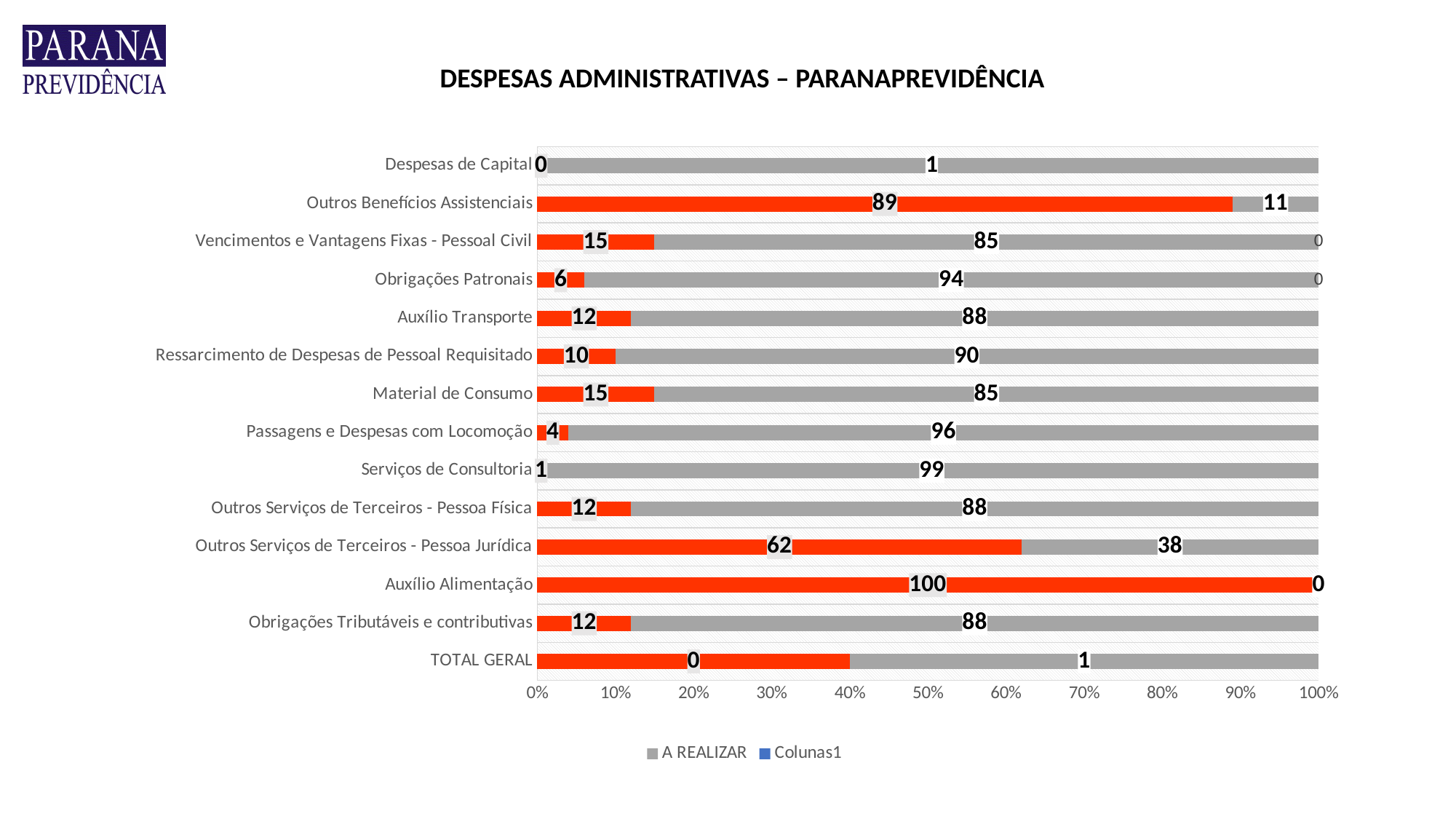
What kind of chart is shown on the slide? Bar chart What is the A REALIZAR value for Outros Serviços de Terceiros - Pessoa Jurídica? 38 Which category has the highest value on its red segment? Auxílio Alimentação How many series does the chart legend list? 2 Which has a larger red segment value, Material de Consumo or Obrigações Patronais? Material de Consumo What is the A REALIZAR value for Obrigações Patronais? 94 How many categories are listed on the vertical axis of the chart? 14 What is the A REALIZAR value for Serviços de Consultoria? 99 Which category has the lowest A REALIZAR value? Auxílio Alimentação Is the red segment for TOTAL GERAL greater or less than 50%? less What value is labelled on the red segment for Outros Benefícios Assistenciais? 89 What is the difference between the A REALIZAR values for Passagens e Despesas com Locomoção and Auxílio Transporte? 8